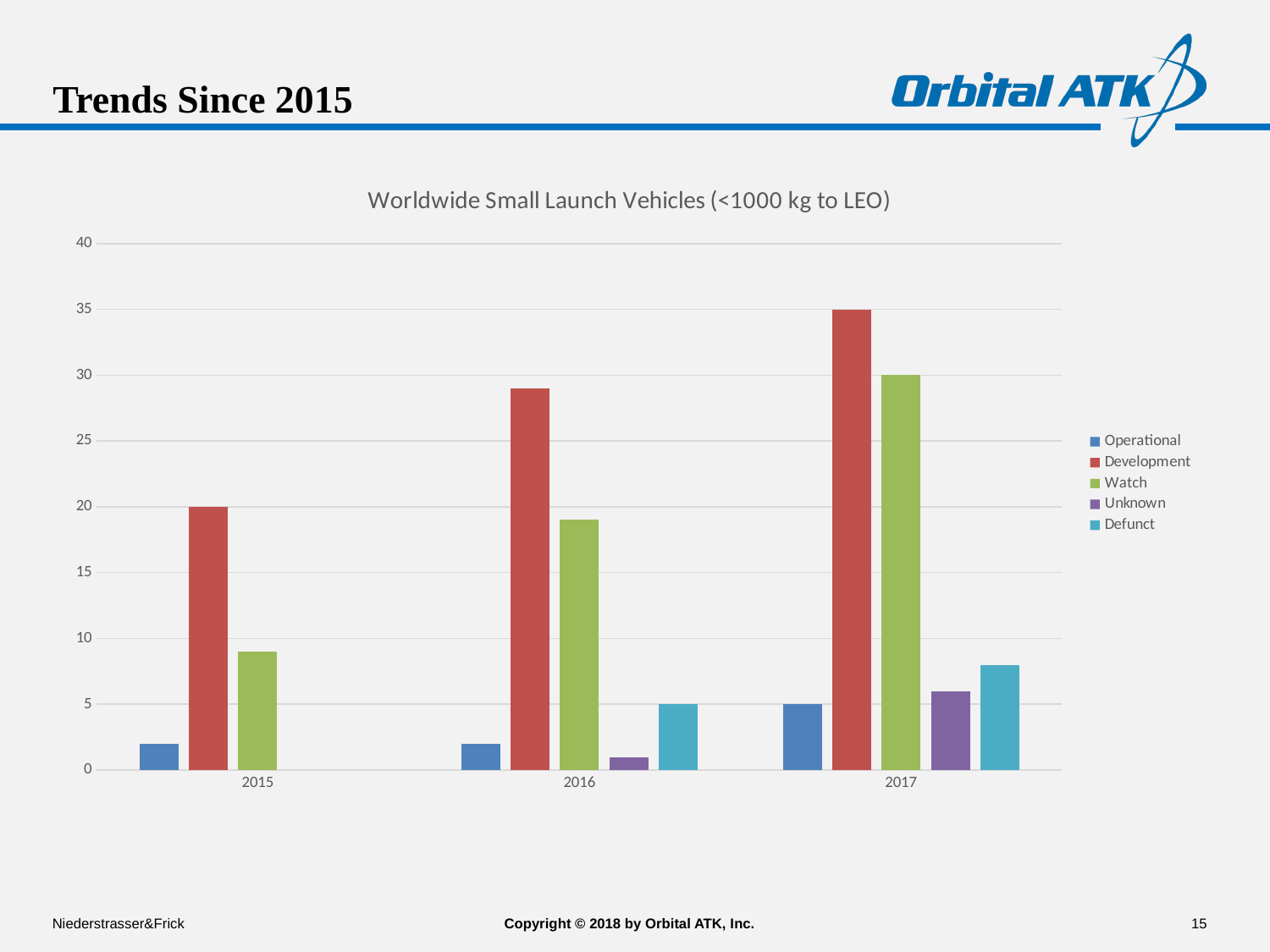
What is the value for Development in 2015? 20 Which series has the shortest bar in 2016? Unknown What is the difference between Development and Watch in 2017? 5 What is the value for Watch in 2017? 30 Does the Development series rise or fall from 2015 to 2017? rise What is the title of the chart? Worldwide Small Launch Vehicles (<1000 kg to LEO) What kind of chart is shown on the slide? bar chart Which series has the tallest bar in 2017? Development How many years are shown on the x axis? 3 Is the value for Watch in 2016 greater or less than 15? greater How many series does the legend list? 5 What is the value for Development in 2017? 35